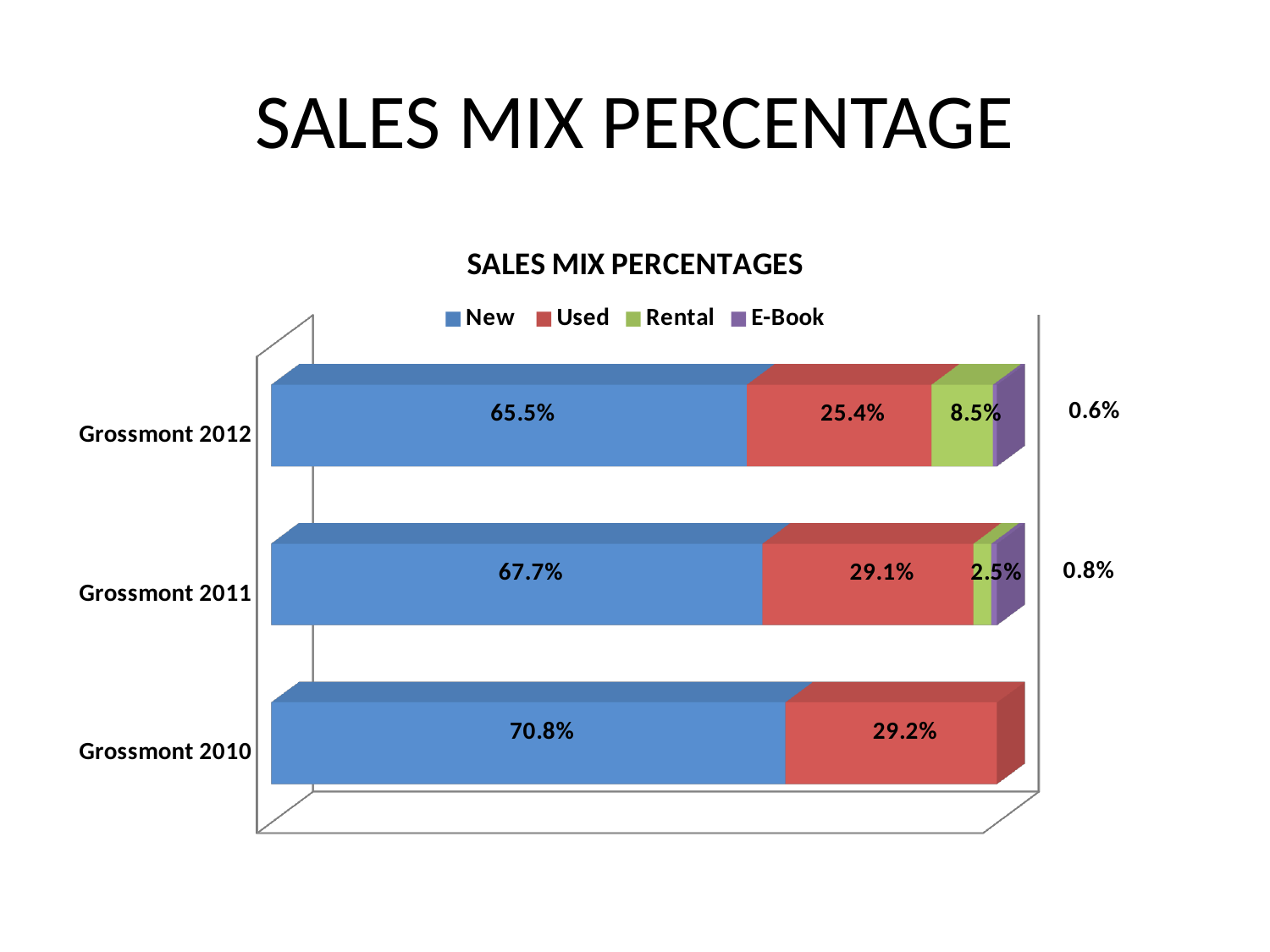
Which is larger, the Rental percentage for Grossmont 2012 or for Grossmont 2011? Grossmont 2012 What is the Rental sales mix percentage for Grossmont 2012? 8.5% What is the Used sales mix percentage for Grossmont 2011? 29.1% Which year has the highest New sales mix percentage? Grossmont 2010 What is the E-Book sales mix percentage for Grossmont 2011? 0.8% What is the New sales mix percentage for Grossmont 2012? 65.5% How many categories (years) are shown on the chart? 3 What is the difference between the New percentage for Grossmont 2010 and Grossmont 2012? 5.3% What is the Used sales mix percentage for Grossmont 2010? 29.2% What kind of chart is shown on the slide? Stacked bar chart How many series does the legend list? 4 Which year has the lowest New sales mix percentage? Grossmont 2012